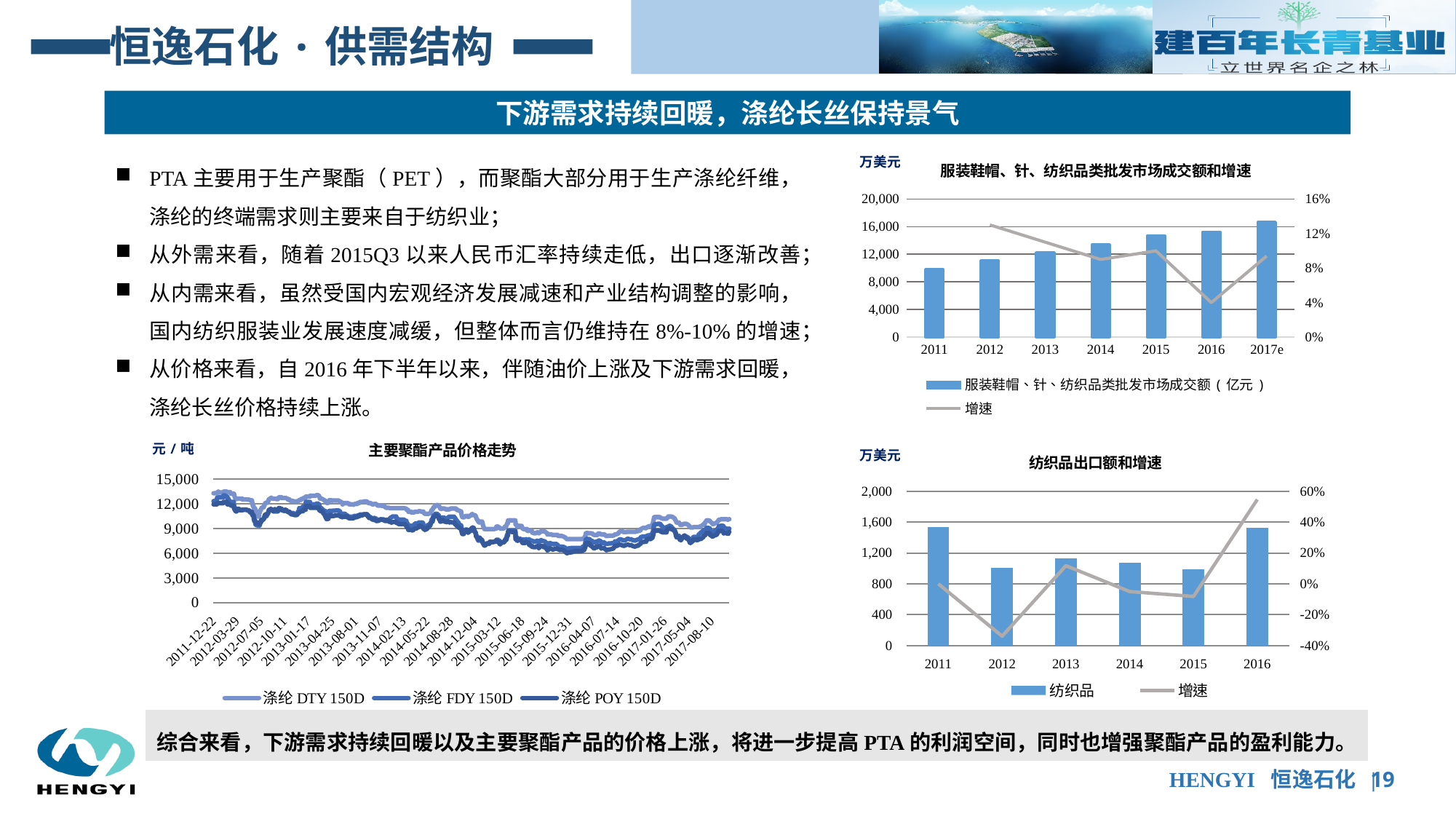
How many series does the legend of the chart titled 主要聚酯产品价格走势 list? 3 In the chart titled 服装鞋帽、针、纺织品类批发市场成交额和增速, which year has the shortest bar? 2011 In the chart titled 服装鞋帽、针、纺织品类批发市场成交额和增速, which year has the tallest bar? 2017e In the chart titled 服装鞋帽、针、纺织品类批发市场成交额和增速, is the bar value for 2011 greater or less than 12,000? less In the chart titled 纺织品出口额和增速, how many series does the legend list? 2 In the chart titled 服装鞋帽、针、纺织品类批发市场成交额和增速, how many years are shown on the x axis? 7 In the chart titled 服装鞋帽、针、纺织品类批发市场成交额和增速, is the bar value for 2017e greater or less than 16,000? greater In the chart titled 纺织品出口额和增速, in which year does the 增速 line reach its lowest point? 2012 In the chart titled 纺织品出口额和增速, in which year does the 增速 line reach its highest point? 2016 In the chart titled 服装鞋帽、针、纺织品类批发市场成交额和增速, do the bar values rise or fall from 2011 to 2017e? rise In the chart titled 服装鞋帽、针、纺织品类批发市场成交额和增速, in which year is the 增速 line at its lowest point? 2016 In the chart titled 纺织品出口额和增速, is the 纺织品 bar for 2016 greater or less than 1,200? greater